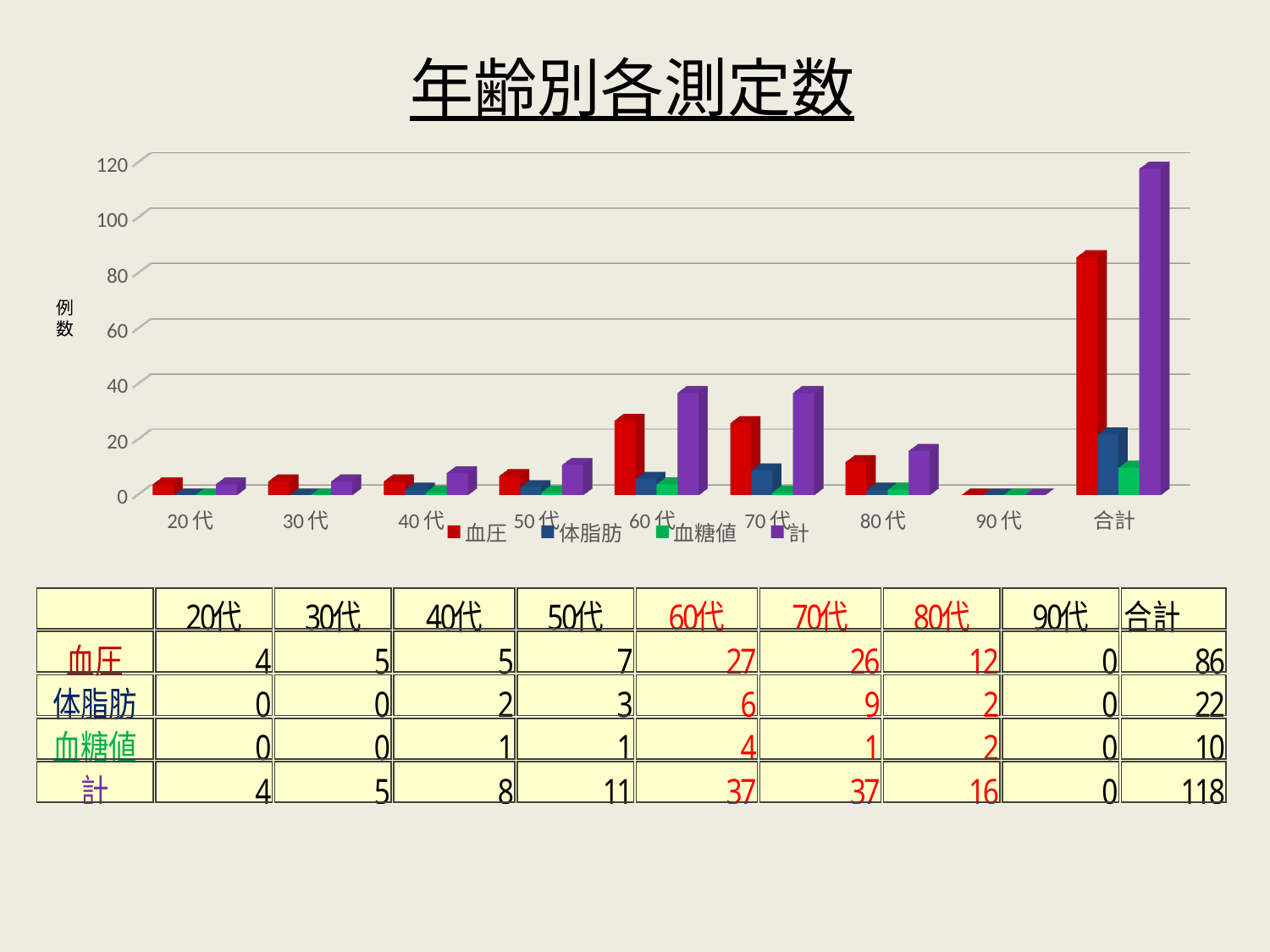
What kind of chart is shown on the slide? bar chart Which age group has the highest 血圧 value (excluding 合計)? 60代 What is the title of the chart? 年齢別各測定数 Which age group has the lowest 計 value? 90代 How many series does the chart legend list? 4 What is the difference between the 血圧 values for 60代 and 80代? 15 What is the value of 血圧 for 60代? 27 How many categories are shown along the x axis of the chart? 9 Which is larger, the 体脂肪 value for 60代 or for 70代? 70代 What is the value of 計 for 合計? 118 Is the 計 value for 合計 greater or less than 100? greater What is the value of 体脂肪 for 70代? 9